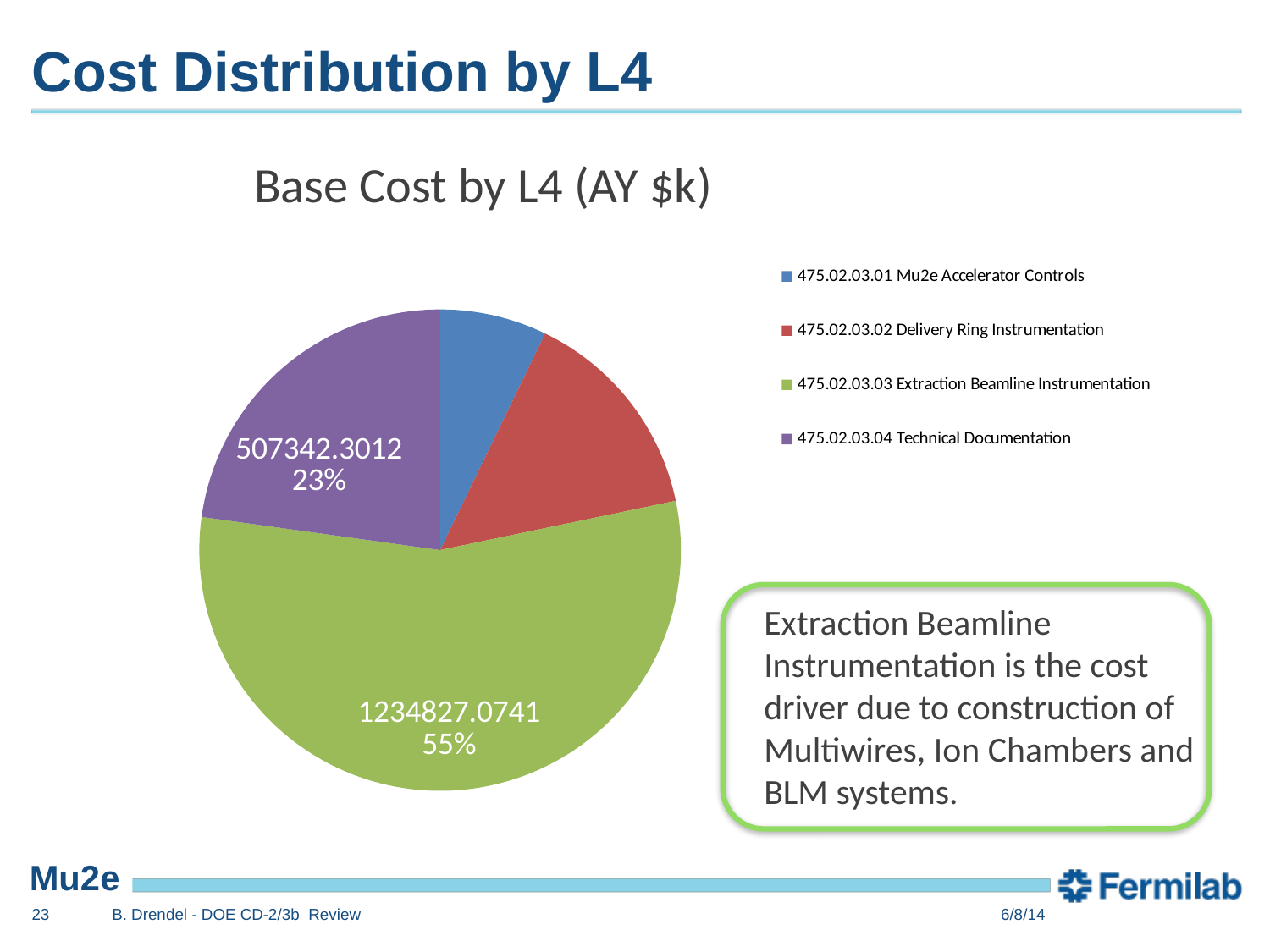
How many slices does the pie chart have? 4 What share of the pie does 475.02.03.03 Extraction Beamline Instrumentation represent? 55% What kind of chart is shown on the slide? pie chart What is the difference between the values for 475.02.03.03 Extraction Beamline Instrumentation and 475.02.03.04 Technical Documentation? 727484.7729 What is the value shown for 475.02.03.03 Extraction Beamline Instrumentation? 1234827.0741 Which category has the smallest slice of the pie? 475.02.03.01 Mu2e Accelerator Controls Which category has the largest slice of the pie? 475.02.03.03 Extraction Beamline Instrumentation What is the value shown for 475.02.03.04 Technical Documentation? 507342.3012 What is the title of the chart? Base Cost by L4 (AY $k) What share of the pie does 475.02.03.04 Technical Documentation represent? 23% How many entries does the legend list? 4 Which is larger, the slice for 475.02.03.02 Delivery Ring Instrumentation or the slice for 475.02.03.01 Mu2e Accelerator Controls? 475.02.03.02 Delivery Ring Instrumentation